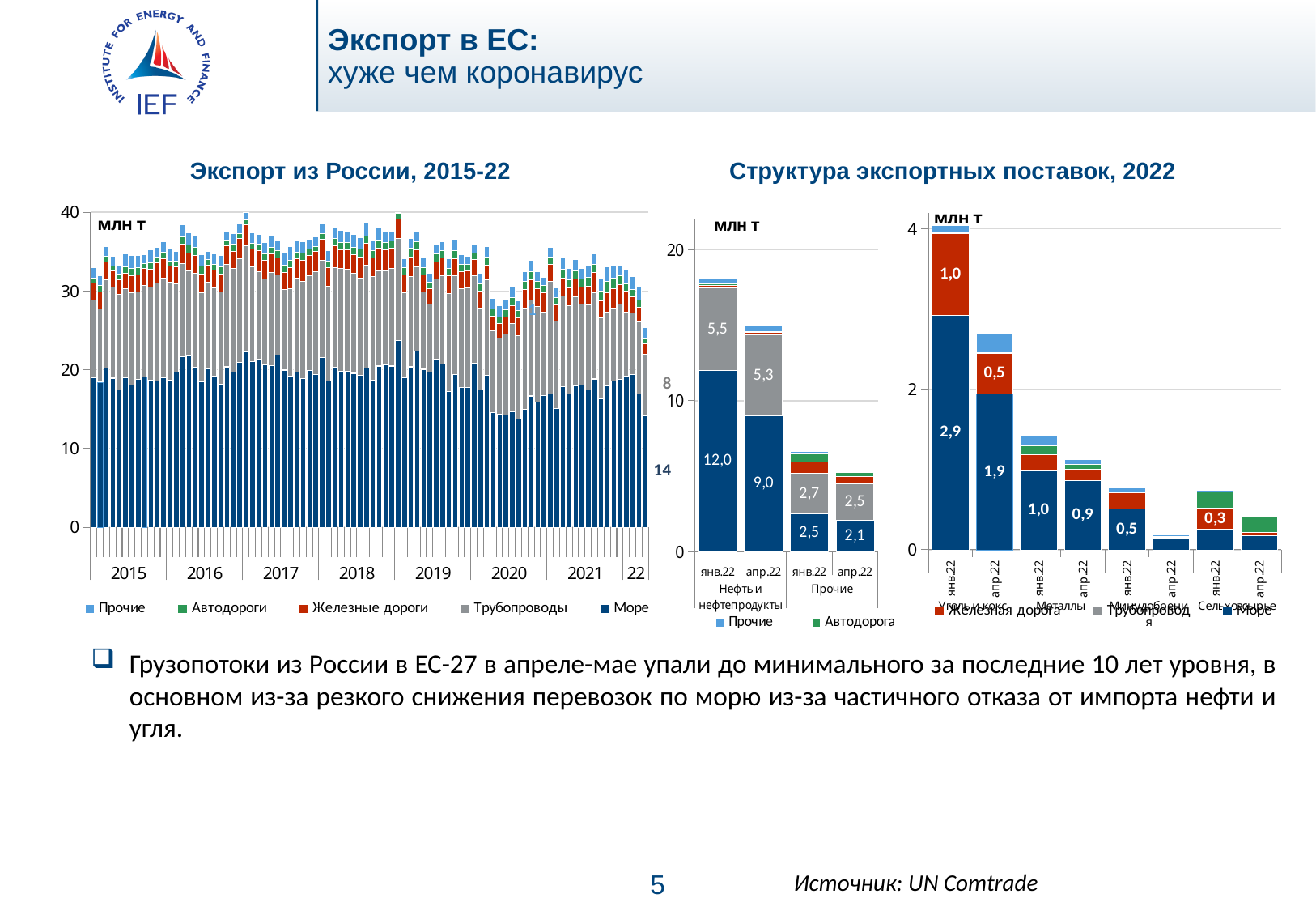
On the chart 'Экспорт из России, 2015-22', what kind of chart is shown? stacked bar chart On the right chart (Уголь и кокс, Металлы, Минудобрения, Сельхозсырье), what is the Железная дорога value for Сельхозсырье in янв.22? 0,3 On the chart 'Экспорт из России, 2015-22', which series is shown in dark blue at the bottom of each bar? Море On the right chart (Уголь и кокс, Металлы, Минудобрения, Сельхозсырье), what is the Море value for Уголь и кокс in янв.22? 2,9 On the chart 'Экспорт из России, 2015-22', how many series does the legend list? 5 On the middle chart (Нефть и нефтепродукты / Прочие), what is the value of Море for Нефть и нефтепродукты in янв.22? 12,0 On the right chart (Уголь и кокс, Металлы, Минудобрения, Сельхозсырье), is the total for Уголь и кокс in янв.22 greater or less than 2? greater On the right chart (Уголь и кокс, Металлы, Минудобрения, Сельхозсырье), what is the Железная дорога value for Уголь и кокс in апр.22? 0,5 On the right chart (Уголь и кокс, Металлы, Минудобрения, Сельхозсырье), which is larger: the Море value for Уголь и кокс in янв.22 or in апр.22? янв.22 On the middle chart (Нефть и нефтепродукты / Прочие), what is the value of Трубопроводы for Нефть и нефтепродукты in апр.22? 5,3 On the middle chart (Нефть и нефтепродукты / Прочие), by how much did the Море value for Нефть и нефтепродукты fall from янв.22 to апр.22? 3,0 On the middle chart (Нефть и нефтепродукты / Прочие), what is the Море value for Прочие in апр.22? 2,1